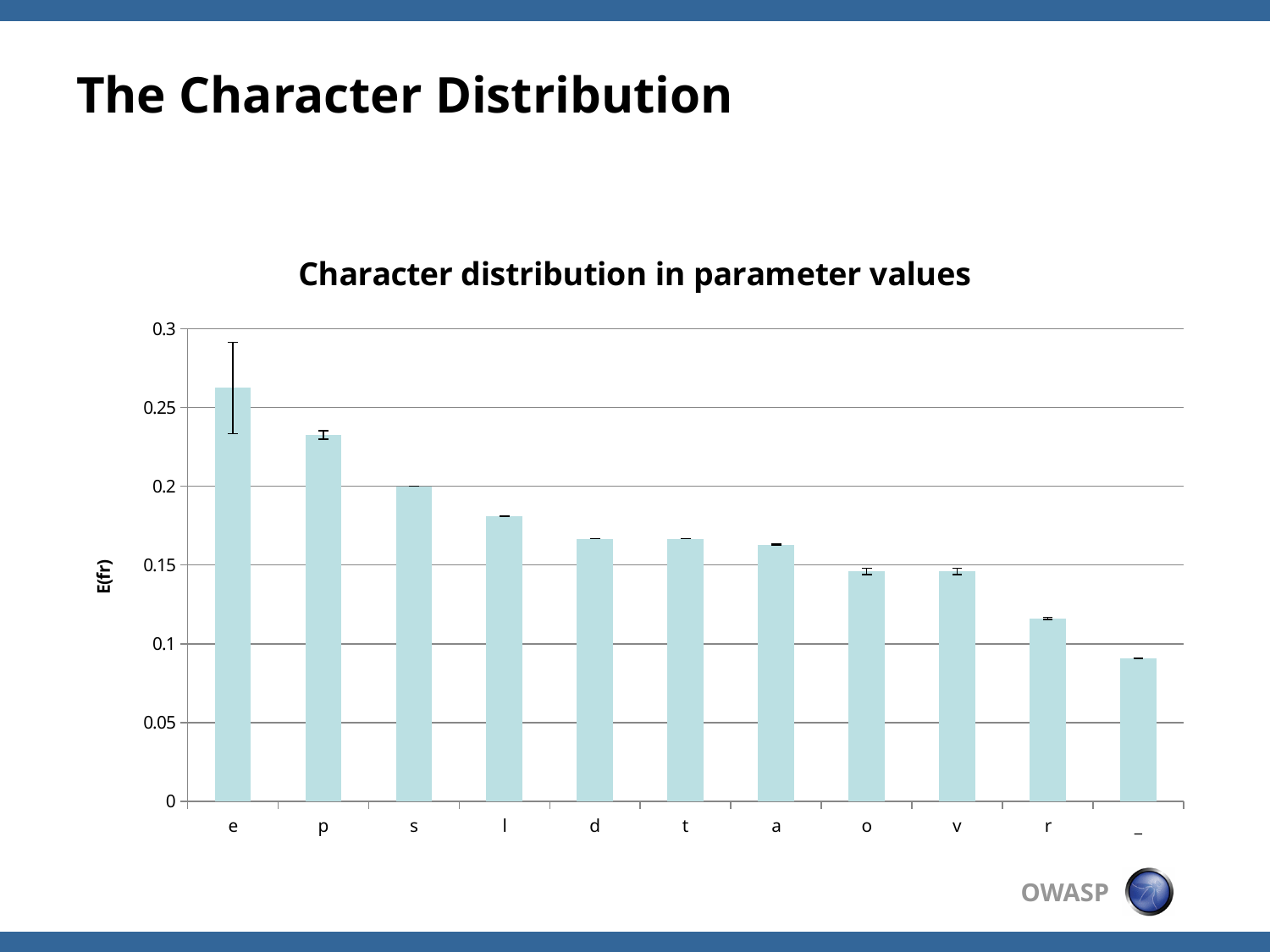
Which character has the lowest E(fr) value? _ Is the value for r greater or less than 0.1? greater Which has a larger E(fr) value, e or p? e What kind of chart is shown on the slide? bar chart Which character has the highest E(fr) value? e What is the label on the vertical axis of the chart? E(fr) Do the E(fr) values rise or fall moving from left to right along the x axis? fall Is the value for e greater or less than 0.25? greater What is the title of the chart? Character distribution in parameter values How many characters (categories) are plotted on the x axis? 11 Is the value for p greater or less than 0.25? less